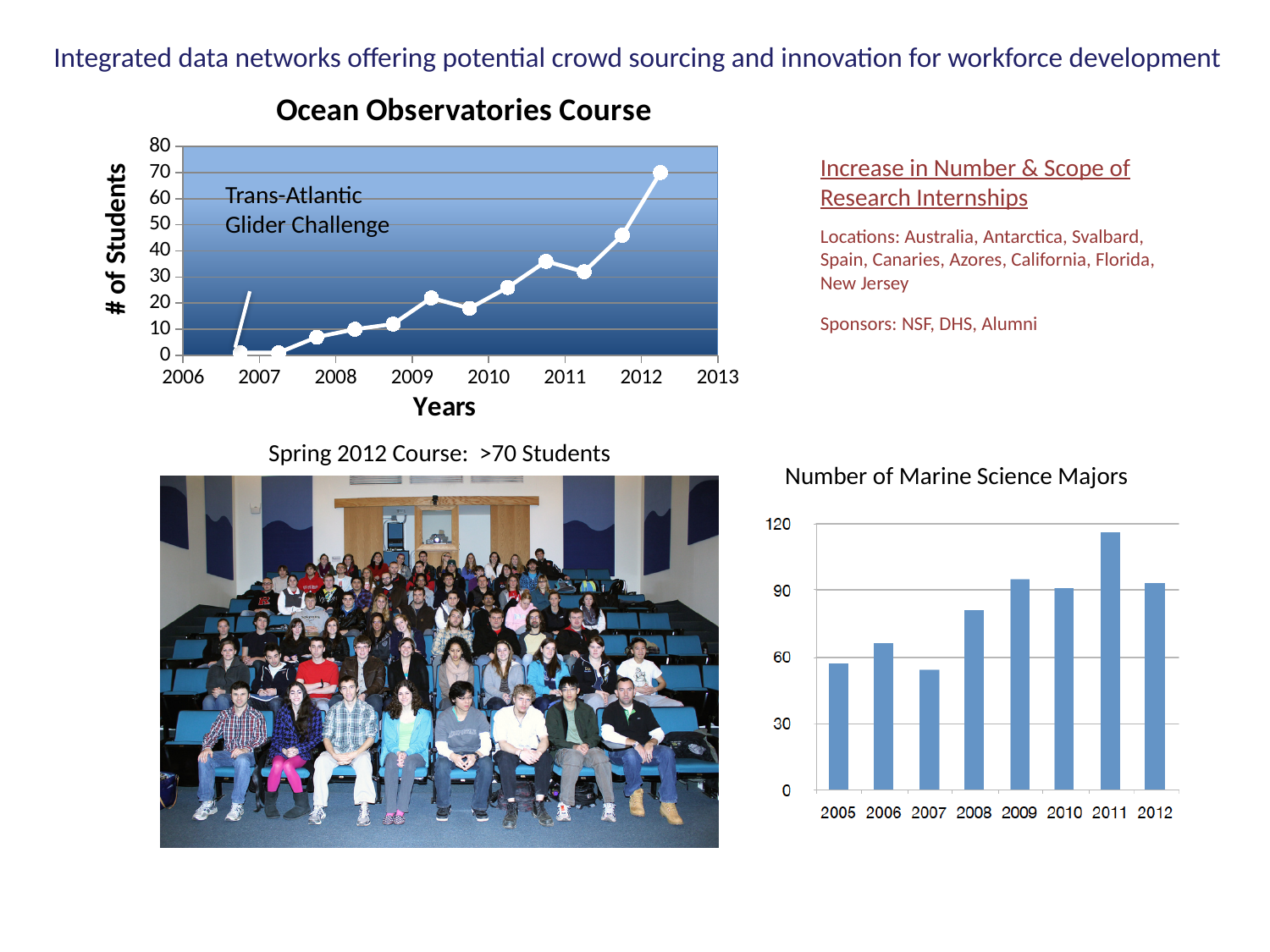
In the "Number of Marine Science Majors" chart, which year has the highest number of majors? 2011 In the "Number of Marine Science Majors" chart, is the value for 2005 greater or less than 60? less How many data points are plotted in the "Ocean Observatories Course" chart? 12 How many years (bars) are shown in the "Number of Marine Science Majors" chart? 8 In the "Number of Marine Science Majors" chart, is the value for 2009 greater or less than 90? greater What kind of chart is the "Number of Marine Science Majors" chart? bar chart In the "Ocean Observatories Course" chart, do the values generally rise or fall from 2006 to 2013? rise What kind of chart is the "Ocean Observatories Course" chart? line chart In the "Number of Marine Science Majors" chart, is the value for 2011 greater or less than 90? greater In the "Number of Marine Science Majors" chart, which is larger, the value for 2008 or the value for 2006? 2008 What is the y-axis label of the "Ocean Observatories Course" chart? # of Students